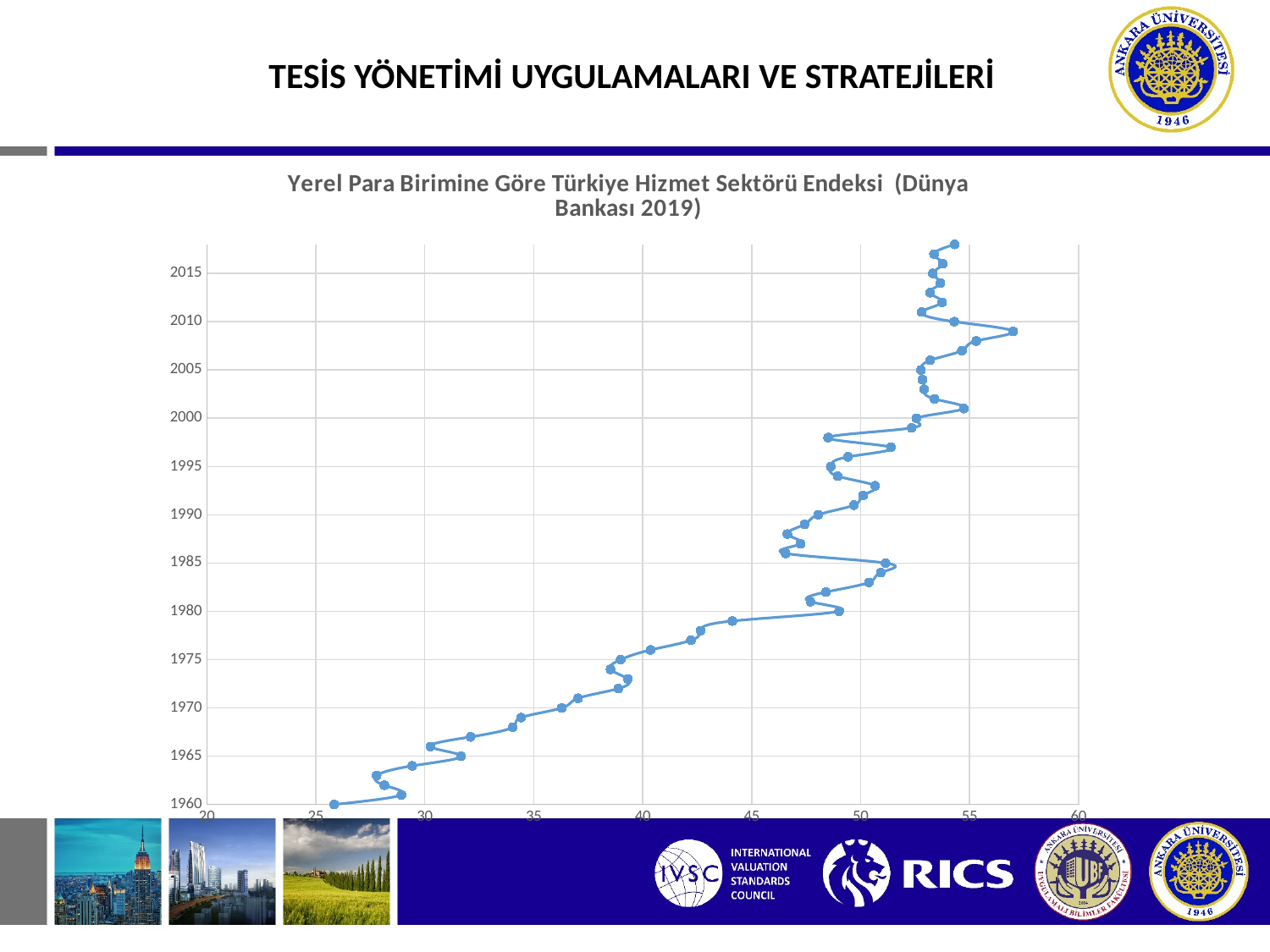
Which year has the lowest index value in the chart? 1960 Which year has the highest index value in the chart? 2009 Overall, does the index value rise or fall as the years go from 1960 to 2015? rise What is the title of the chart? Yerel Para Birimine Göre Türkiye Hizmet Sektörü Endeksi (Dünya Bankası 2019) Is the index value for 1960 greater or less than 30? less Is the index value for 2009 greater or less than 55? greater Is the index value for 1985 greater or less than 50? greater Which year has the larger index value, 1985 or 1986? 1985 What kind of chart is shown on the slide? line chart Which year has the larger index value, 1979 or 1980? 1980